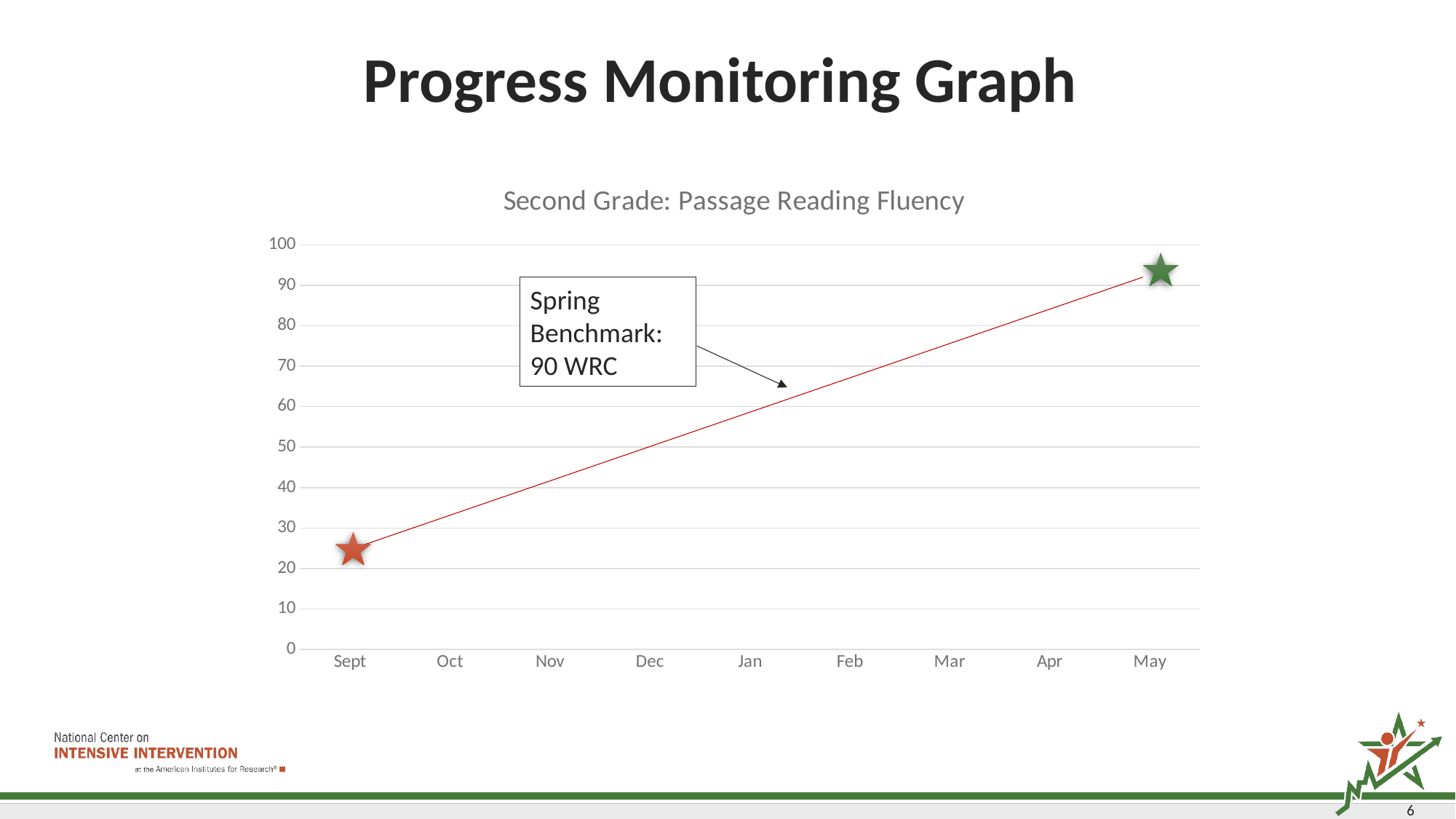
Is the value for May greater or less than 80? greater Is the value for Sept greater or less than 30? less What is the highest value shown on the y axis of the chart? 100 How many months are labelled along the x axis of the chart? 9 Which month has the lowest plotted value? Sept How many data points (stars) are plotted on the chart? 2 Do the values rise or fall from Sept to May along the x axis? rise Which month has the higher plotted value, Sept or May? May What is the title of the chart? Second Grade: Passage Reading Fluency What kind of chart is shown on the slide? line chart Which month has the highest plotted value? May According to the annotation on the chart, what is the Spring Benchmark? 90 WRC